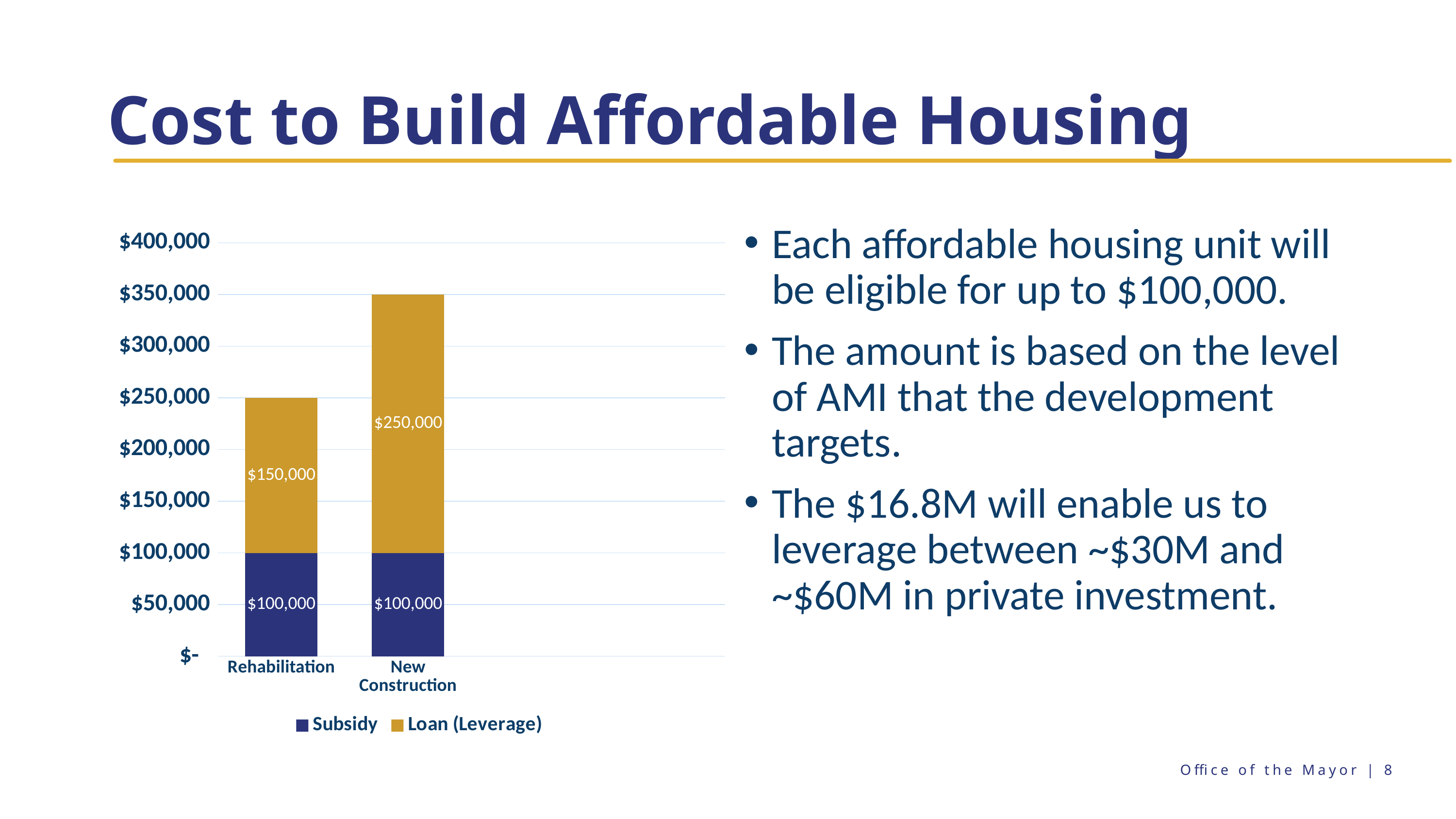
Which category has the higher Loan (Leverage) value, Rehabilitation or New Construction? New Construction What is the Subsidy value for Rehabilitation? $100,000 What is the difference between the Loan (Leverage) values for New Construction and Rehabilitation? $100,000 What is the total of the stacked bar for New Construction? $350,000 What is the total of the stacked bar for Rehabilitation? $250,000 Which category has the highest total cost? New Construction What is the Loan (Leverage) value for Rehabilitation? $150,000 How many categories are shown on the x axis? 2 How many series does the legend list? 2 What is the Subsidy value for New Construction? $100,000 What kind of chart is shown on the slide? Stacked bar chart What is the Loan (Leverage) value for New Construction? $250,000